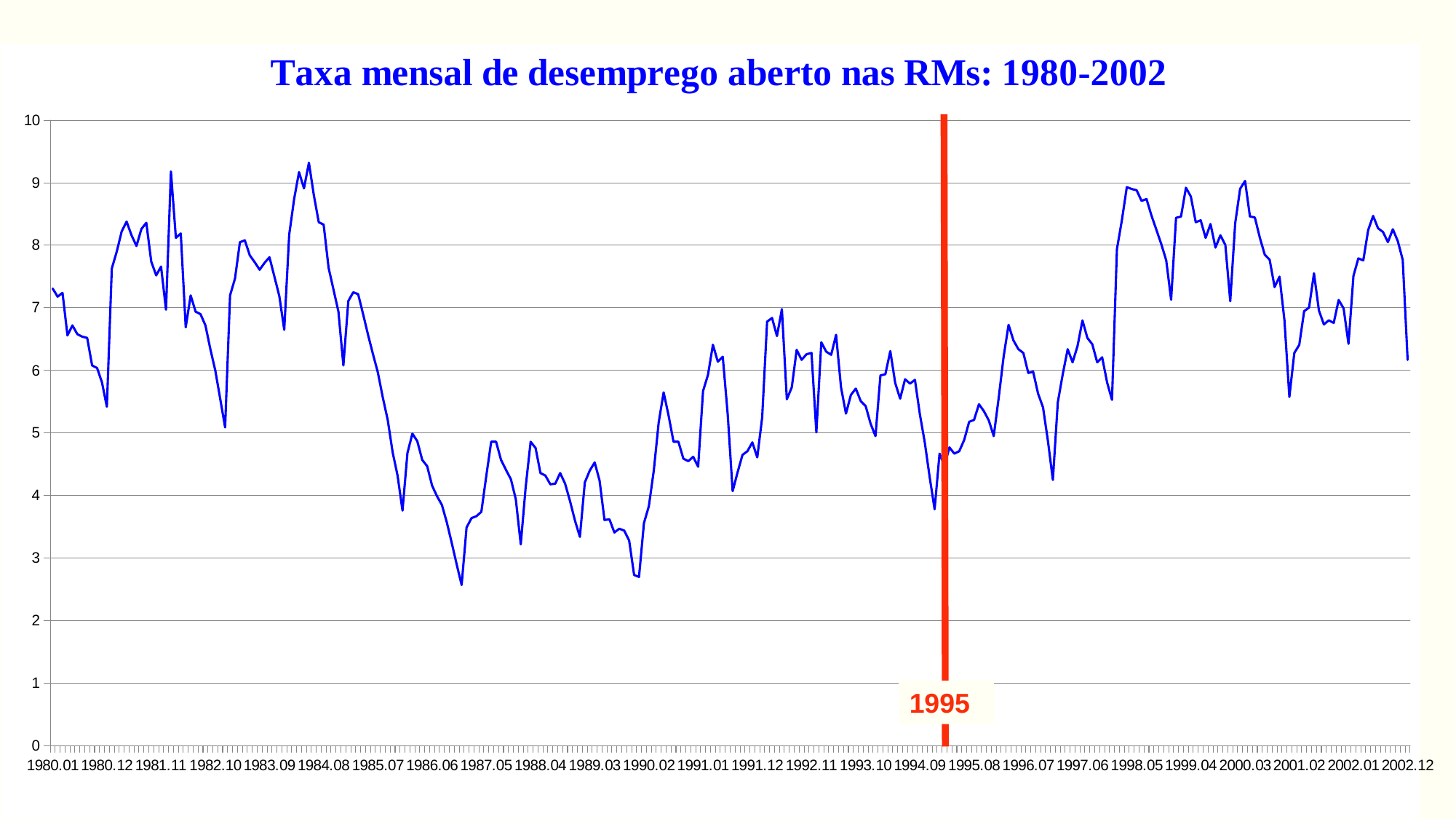
Does the line generally rise or fall between 1995.08 and 1998.05? rise Is the value for 1999.04 greater or less than 7? greater What is the title of the chart? Taxa mensal de desemprego aberto nas RMs: 1980-2002 Is the value for 1998.05 greater or less than 8? greater Is the value for 2002.12 greater or less than 5? greater What is the highest value shown on the vertical axis? 10 Does the line generally rise or fall between 1984.08 and 1986.06? fall What year is labelled on the vertical red line in the chart? 1995 What kind of chart is shown on the slide? line chart